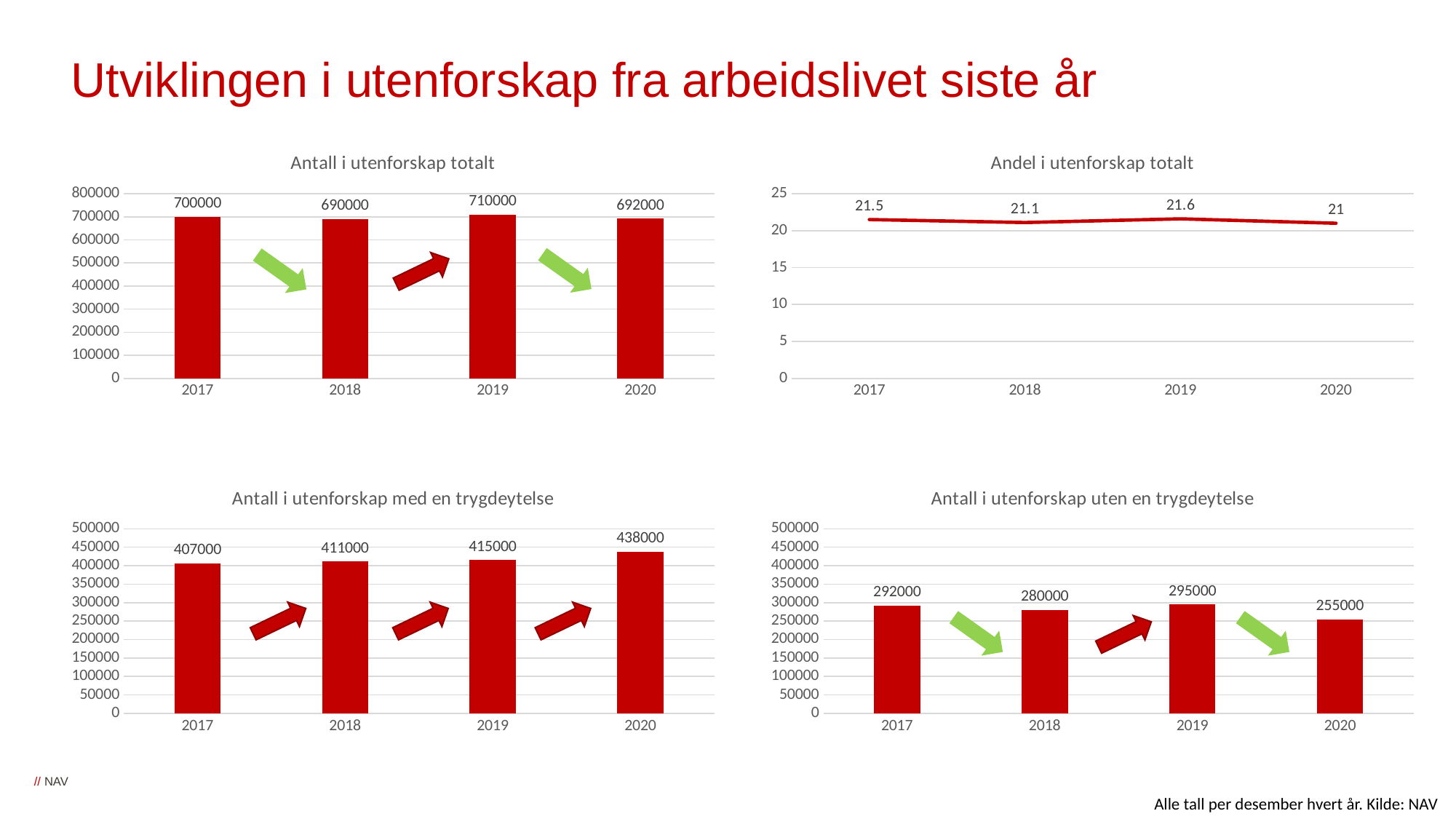
In the chart titled "Antall i utenforskap uten en trygdeytelse", which year has the lowest value? 2020 In the chart titled "Antall i utenforskap totalt", what is the value for 2019? 710000 In the chart titled "Antall i utenforskap uten en trygdeytelse", which is larger, the value for 2017 or 2019? 2019 What kind of chart is "Andel i utenforskap totalt"? line chart In the chart titled "Andel i utenforskap totalt", what is the value for 2020? 21 How many years are shown on the x axis of the chart titled "Antall i utenforskap totalt"? 4 In the chart titled "Antall i utenforskap med en trygdeytelse", what is the difference between the 2020 and 2017 values? 31000 In the chart titled "Antall i utenforskap uten en trygdeytelse", what is the value for 2018? 280000 In the chart titled "Antall i utenforskap totalt", which year has the lowest value? 2018 In the chart titled "Andel i utenforskap totalt", which year has the highest value? 2019 In the chart titled "Antall i utenforskap med en trygdeytelse", what is the value for 2020? 438000 In the chart titled "Antall i utenforskap med en trygdeytelse", do the values rise or fall from 2017 to 2020? rise